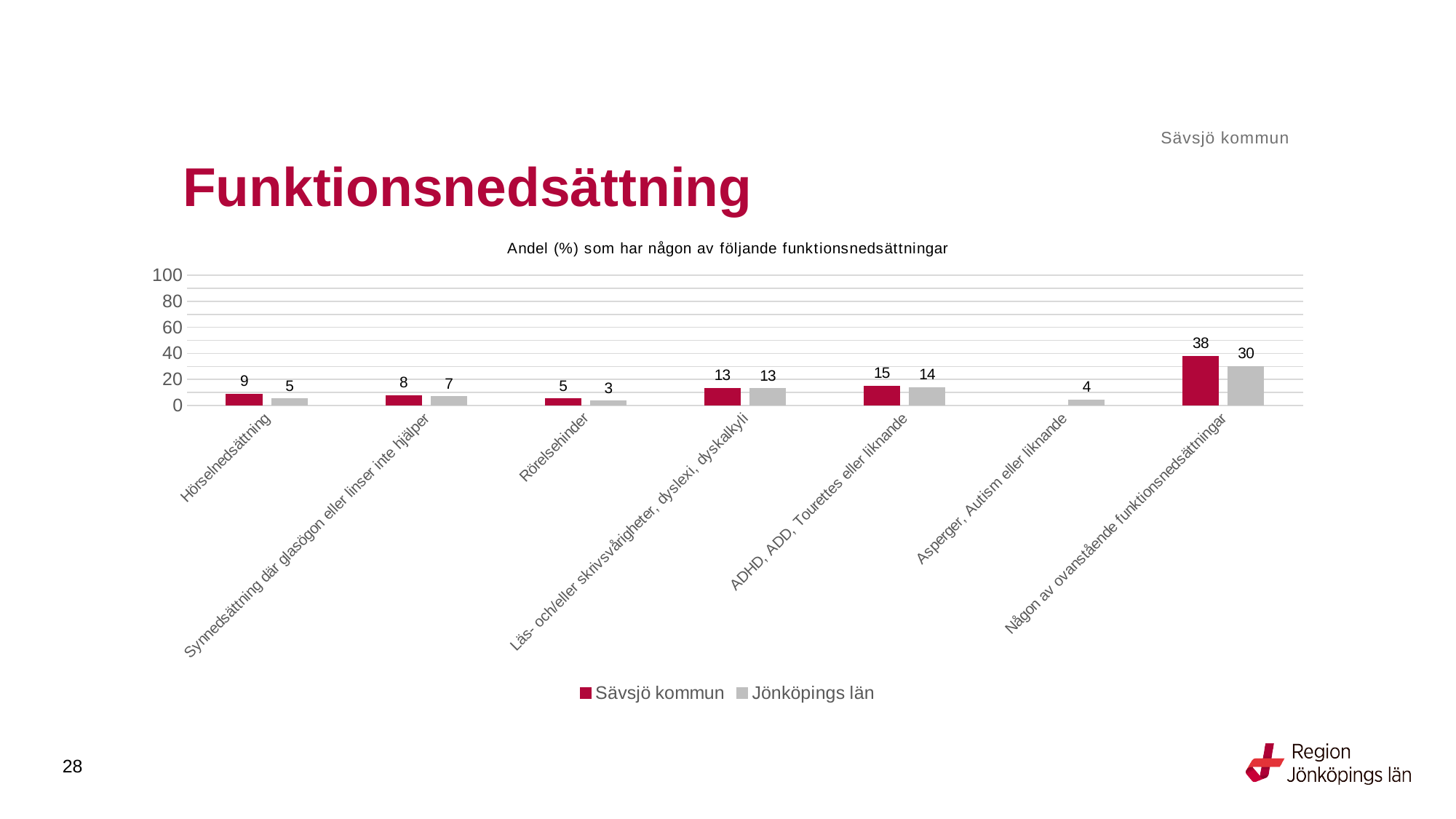
What is the value for Sävsjö kommun for ADHD, ADD, Tourettes eller liknande? 15 What is the difference between Sävsjö kommun and Jönköpings län for Någon av ovanstående funktionsnedsättningar? 8 What is the value for Sävsjö kommun for Hörselnedsättning? 9 How many series does the legend list? 2 Which category has the lowest value for Jönköpings län? Rörelsehinder What is the value for Jönköpings län for Asperger, Autism eller liknande? 4 How many categories are shown on the x axis? 7 What type of chart is shown on the slide? Bar chart Which category has the highest value for Sävsjö kommun? Någon av ovanstående funktionsnedsättningar What is the value for Jönköpings län for Rörelsehinder? 3 Which is larger for Hörselnedsättning: Sävsjö kommun or Jönköpings län? Sävsjö kommun Is the value for Sävsjö kommun for Någon av ovanstående funktionsnedsättningar greater or less than 20? greater